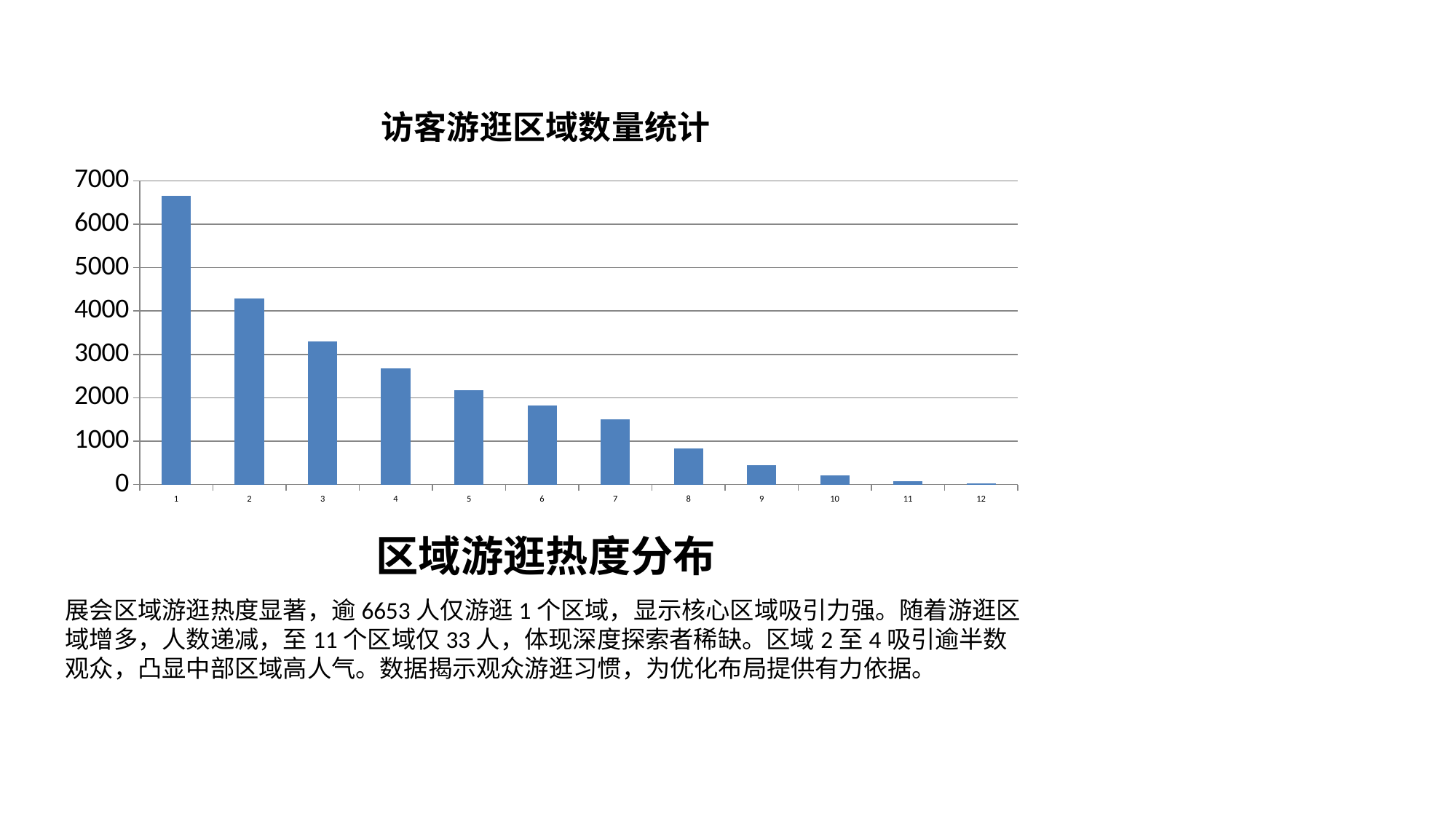
What kind of chart is shown on the slide? bar chart Is the value for category 8 greater or less than 1000? less Which is larger, the value for category 3 or the value for category 5? category 3 Which category has the highest value in the chart? 1 Is the value for category 2 greater or less than 4000? greater How many categories are shown on the x axis of the chart? 12 Is the value for category 4 greater or less than 3000? less What is the title of the chart? 访客游逛区域数量统计 Do the values rise or fall as you move from category 1 to category 12 along the x axis? fall Which category has the lowest value in the chart? 12